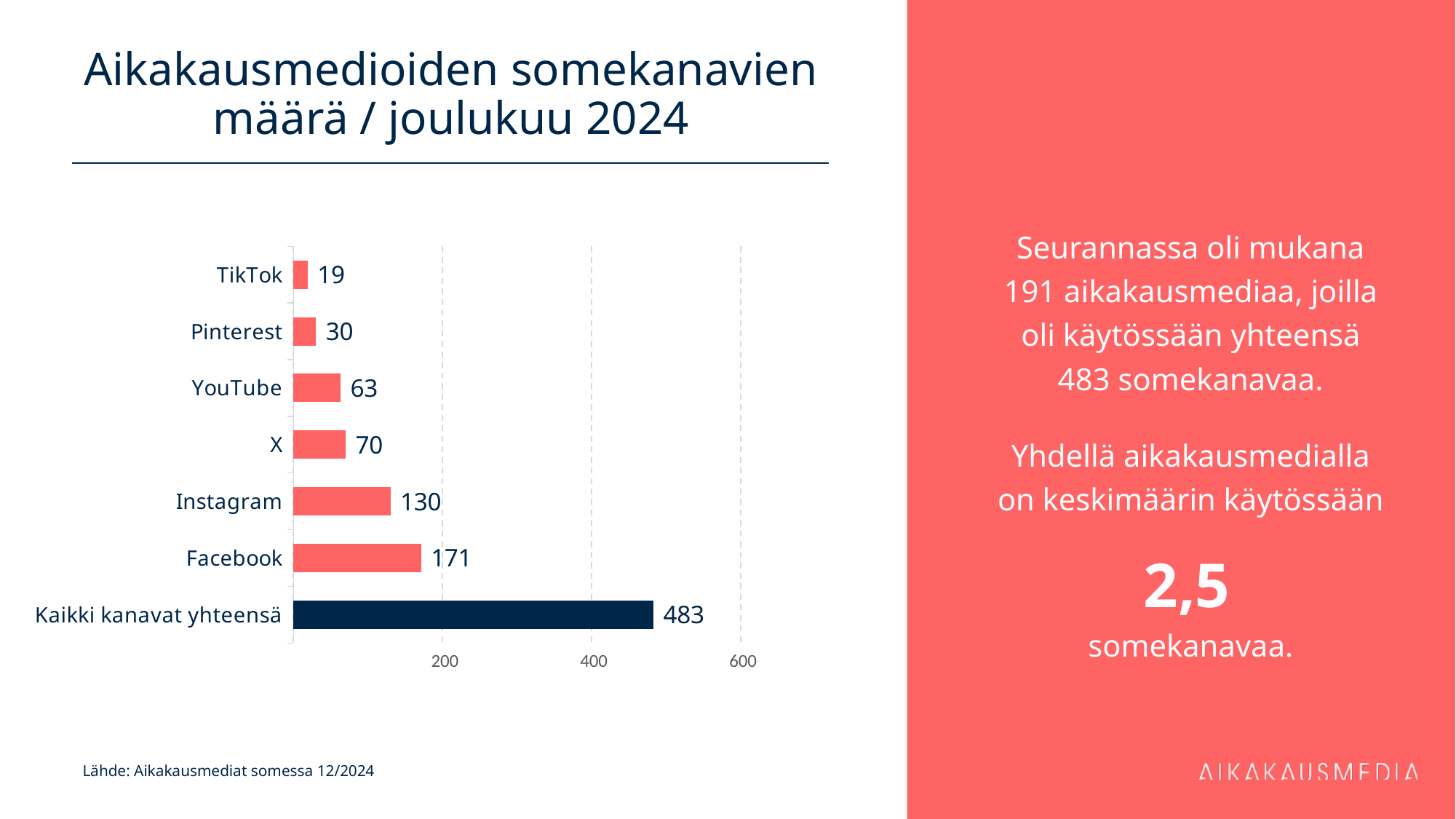
Which category has the lowest value? TikTok Which is larger, the value for Pinterest or the value for YouTube? YouTube What is the difference between the values for X and YouTube? 7 Which individual channel (excluding the total bar) has the highest value? Facebook How many categories are shown in the chart? 7 What is the value for Instagram? 130 What is the title of the chart? Aikakausmedioiden somekanavien määrä / joulukuu 2024 What is the difference between the values for Facebook and Instagram? 41 What is the value for TikTok? 19 What kind of chart is shown on the slide? Bar chart What is the value for Facebook? 171 What is the value for Kaikki kanavat yhteensä? 483